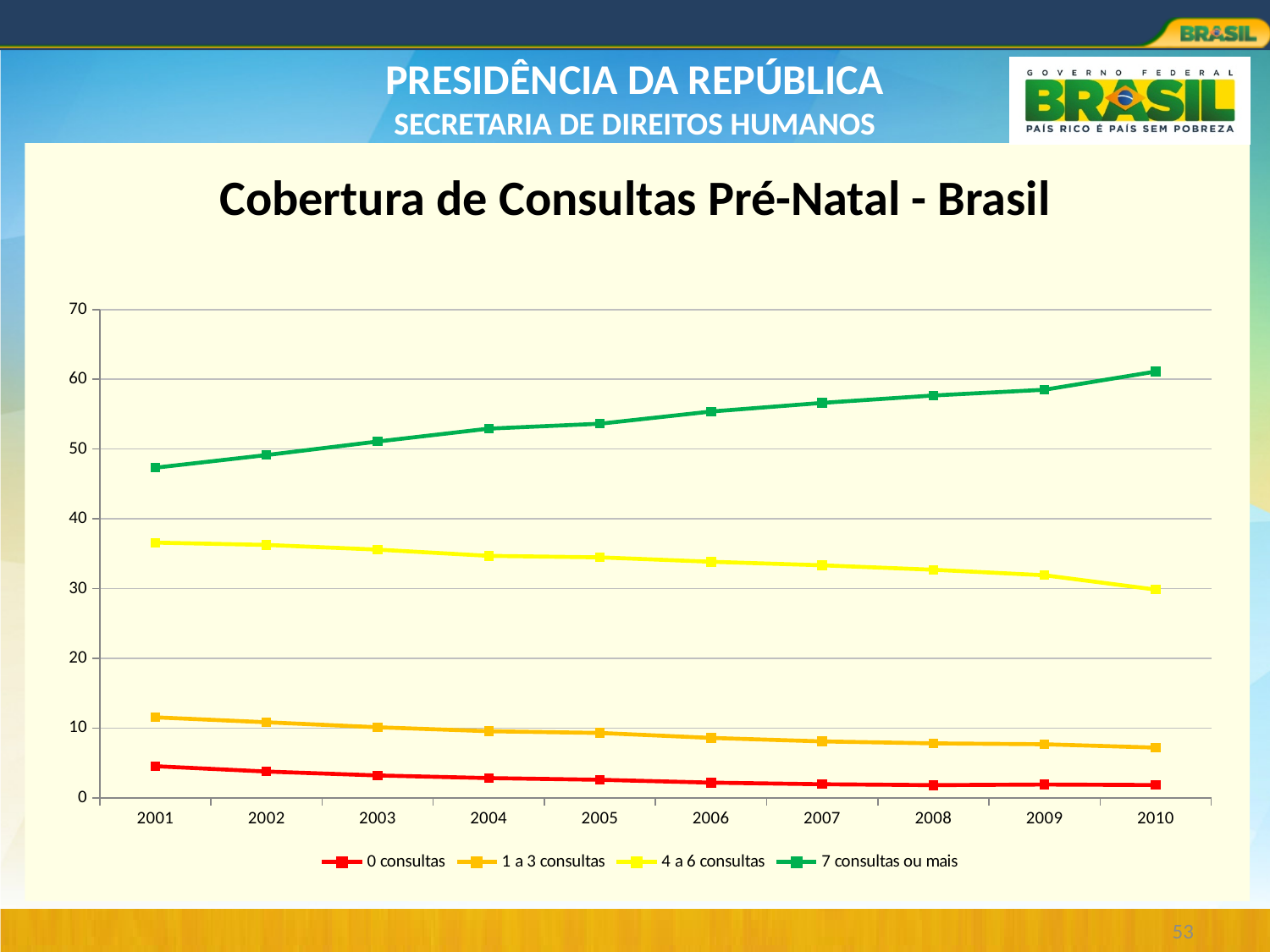
In 2005, which is larger: "7 consultas ou mais" or "4 a 6 consultas"? 7 consultas ou mais How many years are plotted along the x axis? 10 In which year is the value for "7 consultas ou mais" highest? 2010 Do the values for "7 consultas ou mais" rise or fall from 2001 to 2010? rise What kind of chart is shown on the slide? line chart Do the values for "4 a 6 consultas" rise or fall from 2001 to 2010? fall Is the value for "4 a 6 consultas" in 2001 greater or less than 40? less Is the value for "7 consultas ou mais" in 2001 greater or less than 50? less How many series does the legend list? 4 Is the value for "0 consultas" in 2001 greater or less than 10? less In which year is the value for "4 a 6 consultas" lowest? 2010 What is the title of the chart? Cobertura de Consultas Pré-Natal - Brasil